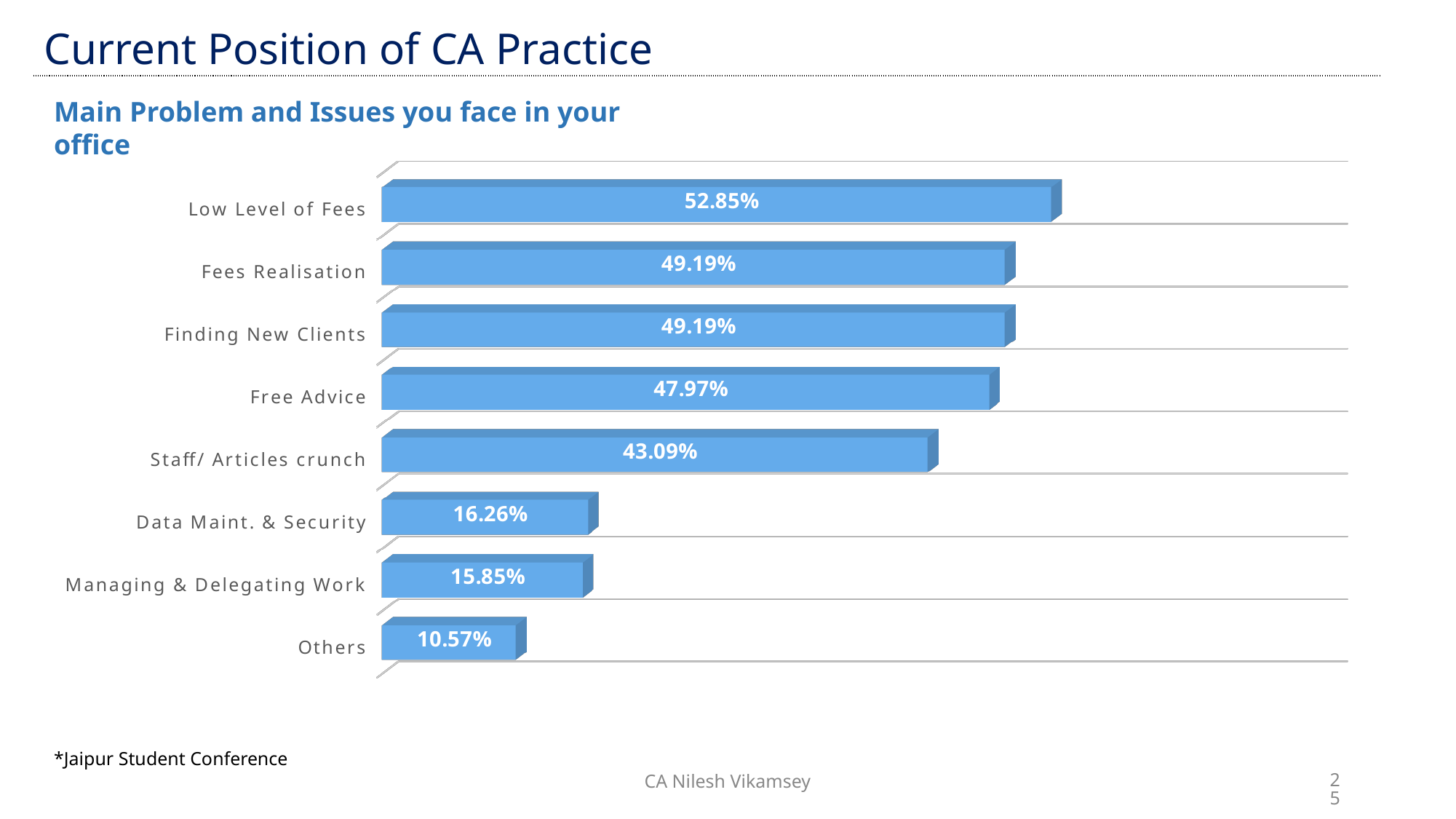
How many categories are shown in the chart? 8 Which category has the lowest value? Others What is the value for Others? 10.57% What is the difference between the values for Data Maint. & Security and Managing & Delegating Work? 0.41% Which category has the highest value? Low Level of Fees What kind of chart is shown on the slide? Bar chart Which is larger, the value for Staff/ Articles crunch or the value for Data Maint. & Security? Staff/ Articles crunch What is the difference between the values for Low Level of Fees and Free Advice? 4.88% What is the value for Data Maint. & Security? 16.26% What is the title of the chart? Main Problem and Issues you face in your office What is the value for Low Level of Fees? 52.85% What is the value for Staff/ Articles crunch? 43.09%